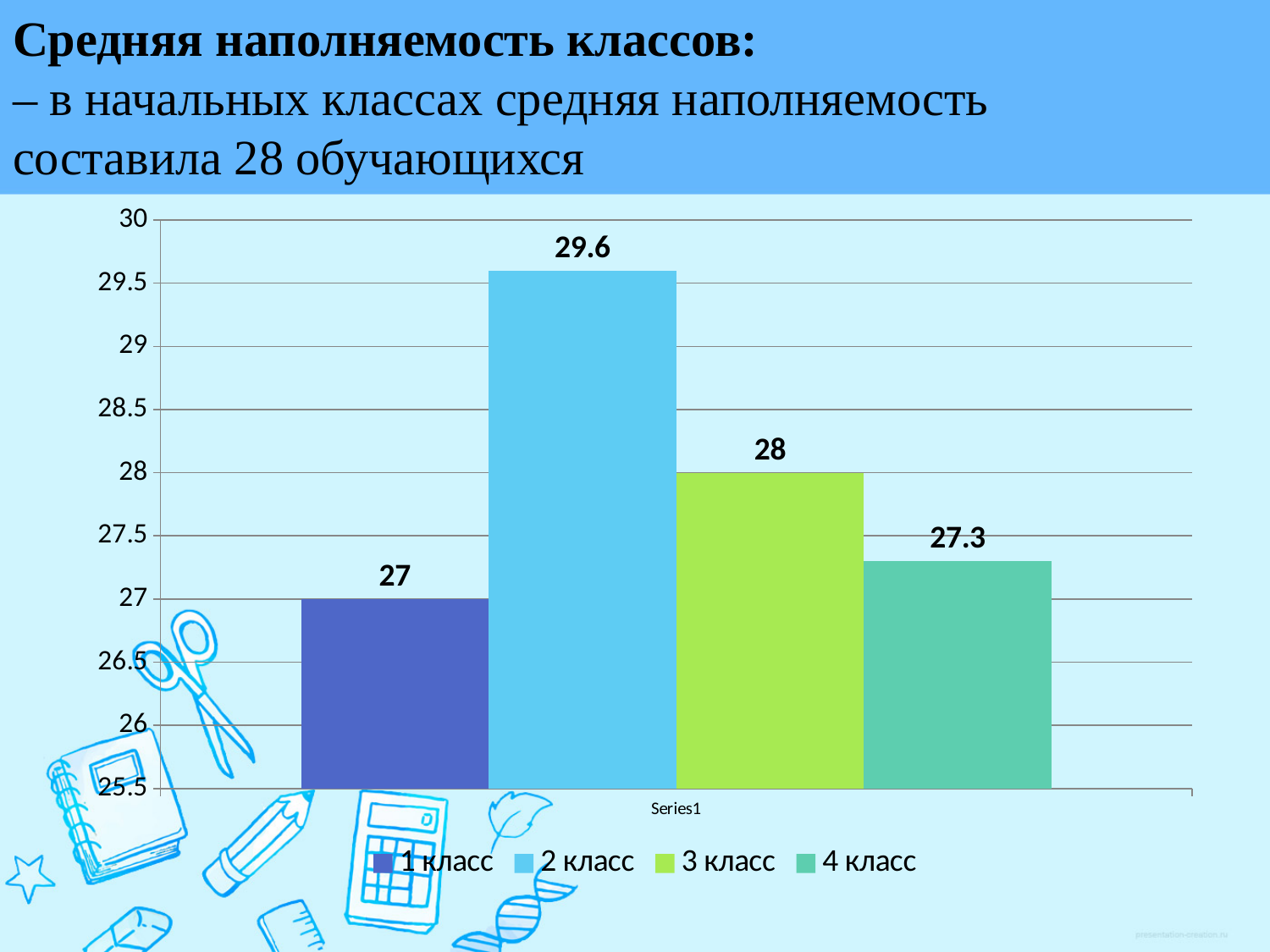
How many entries does the legend list? 4 How many bars are shown in the chart? 4 What is the difference between the values for 3 класс and 4 класс? 0.7 What kind of chart is shown on the slide? bar chart What is the difference between the values for 2 класс and 1 класс? 2.6 Which class has the lowest value? 1 класс What is the value for 2 класс? 29.6 What is the value for 3 класс? 28 Which is larger, the value for 3 класс or the value for 4 класс? 3 класс What is the value for 4 класс? 27.3 What is the value for 1 класс? 27 Which class has the highest value? 2 класс